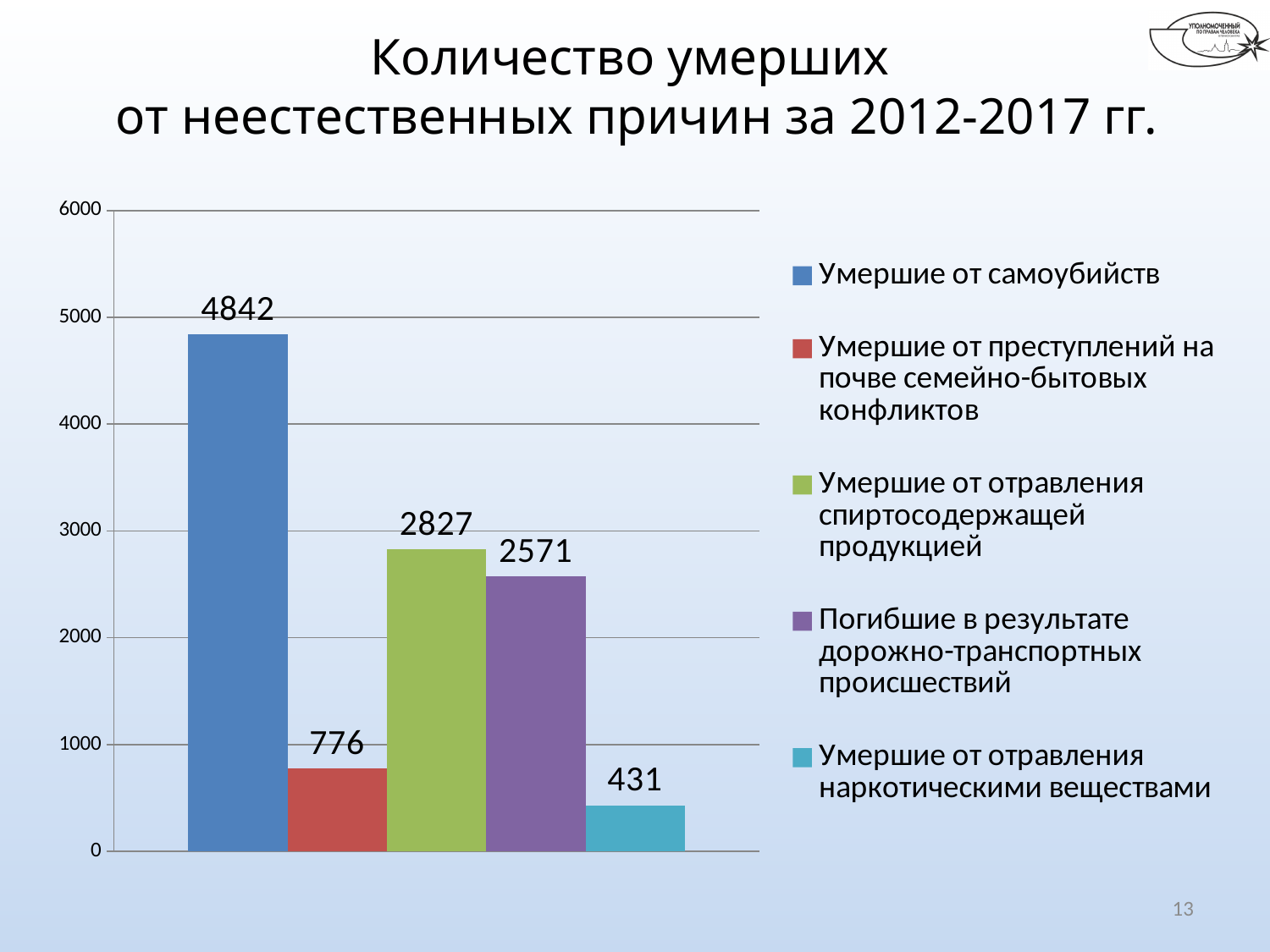
What is the value for "Умершие от отравления наркотическими веществами"? 431 What colour is the bar for "Умершие от самоубийств"? blue What is the difference between the value for "Умершие от самоубийств" and the value for "Умершие от преступлений на почве семейно-бытовых конфликтов"? 4066 Which category has the lowest value? Умершие от отравления наркотическими веществами Which is larger: the value for "Умершие от преступлений на почве семейно-бытовых конфликтов" or the value for "Умершие от отравления наркотическими веществами"? Умершие от преступлений на почве семейно-бытовых конфликтов How many bars are shown in the chart? 5 What is the value for "Умершие от самоубийств"? 4842 What is the difference between the value for "Умершие от отравления спиртосодержащей продукцией" and the value for "Погибшие в результате дорожно-транспортных происшествий"? 256 What kind of chart is shown on the slide? bar chart Is the value for "Умершие от отравления спиртосодержащей продукцией" greater or less than 3000? less Which category has the highest value? Умершие от самоубийств What is the value for "Погибшие в результате дорожно-транспортных происшествий"? 2571